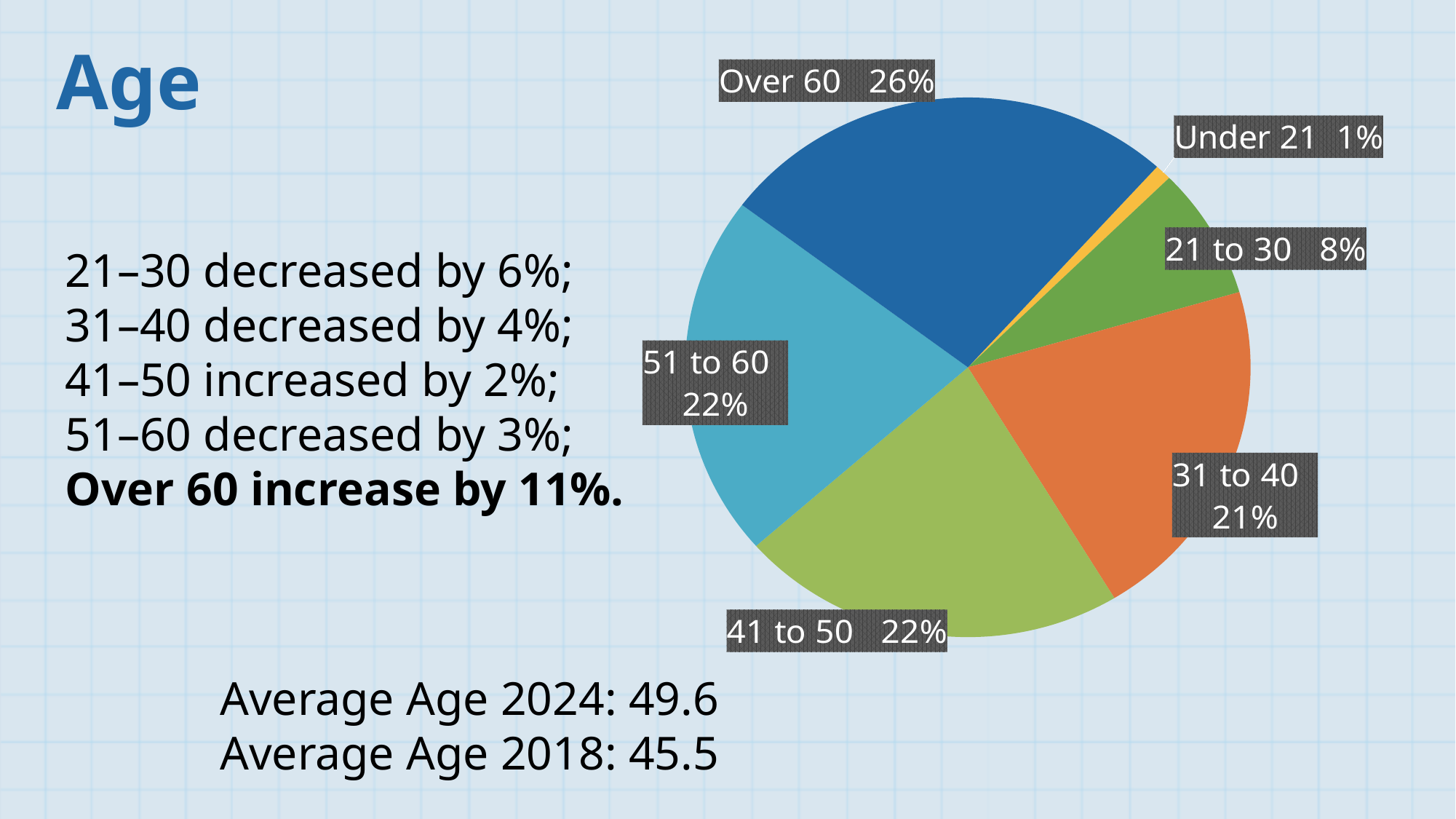
What is the value shown for the Under 21 slice? 1% What is the value shown for the 31 to 40 slice? 21% What is the combined share of the 41 to 50 and 51 to 60 slices? 44% What colour is the Over 60 slice? dark blue Which age group has the largest slice of the pie? Over 60 What share of the pie does the Over 60 slice represent? 26% Which is larger, the 21 to 30 slice or the 51 to 60 slice? 51 to 60 What is the value shown for the 21 to 30 slice? 8% Which age group has the smallest slice of the pie? Under 21 How many slices does the pie chart have? 6 What kind of chart is shown on the slide? pie chart What is the difference in percentage points between the Over 60 slice and the 31 to 40 slice? 5%